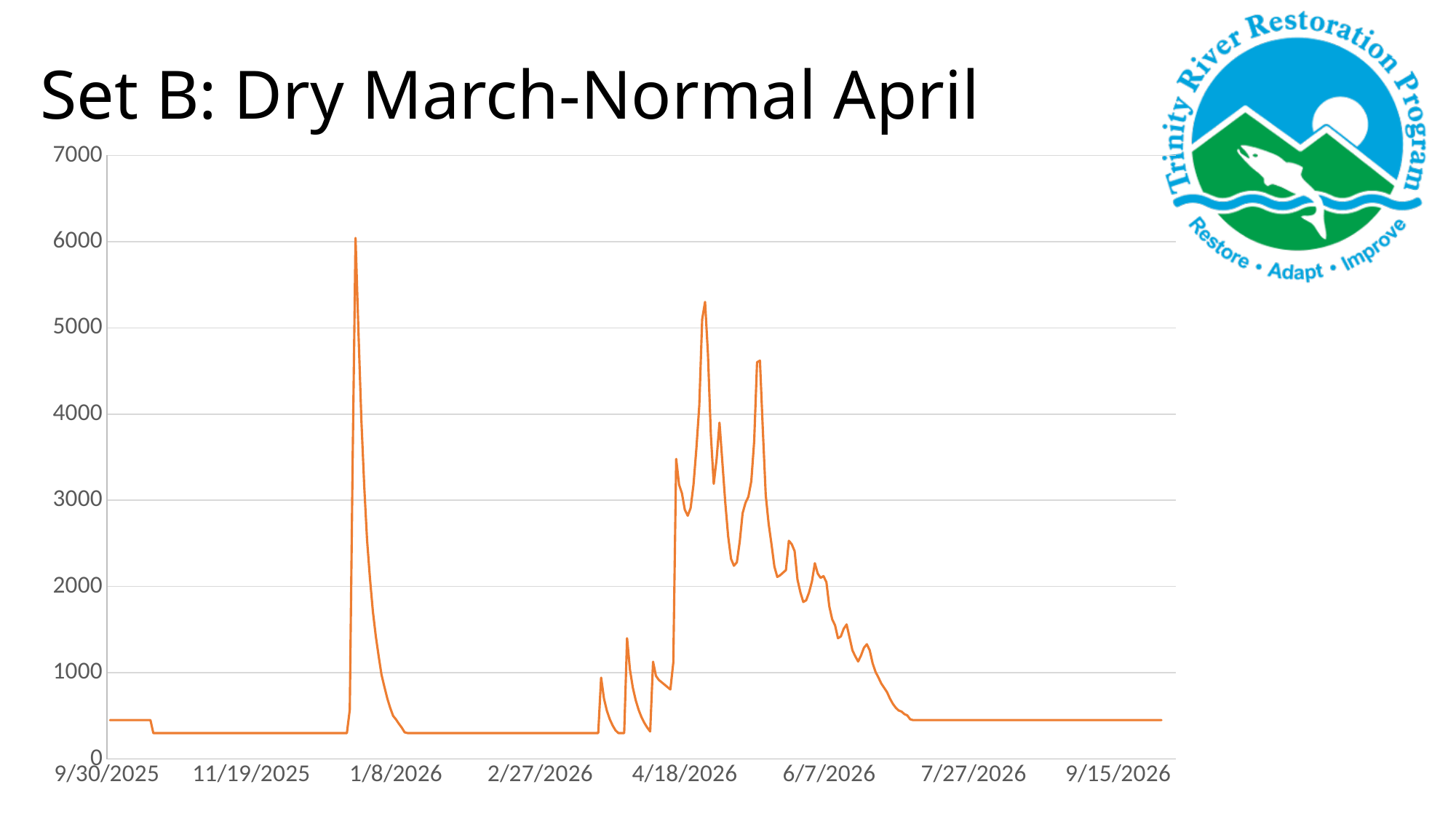
Is the highest peak between 4/18/2026 and 6/7/2026 greater or less than 5000? greater What is the title of the chart on the slide? Set B: Dry March-Normal April Is the value on 2/27/2026 greater or less than 500? less What is the highest value shown on the vertical axis? 7000 How many date labels are shown along the x axis? 8 Between 7/27/2026 and 9/15/2026, does the line rise, fall, or stay flat? stay flat Is the value on 9/15/2026 greater or less than 1000? less What kind of chart is shown on the slide? line chart Between 6/7/2026 and 7/27/2026, does the line generally rise or fall? fall Which is higher: the peak just before 1/8/2026 or the highest peak between 4/18/2026 and 6/7/2026? the peak just before 1/8/2026